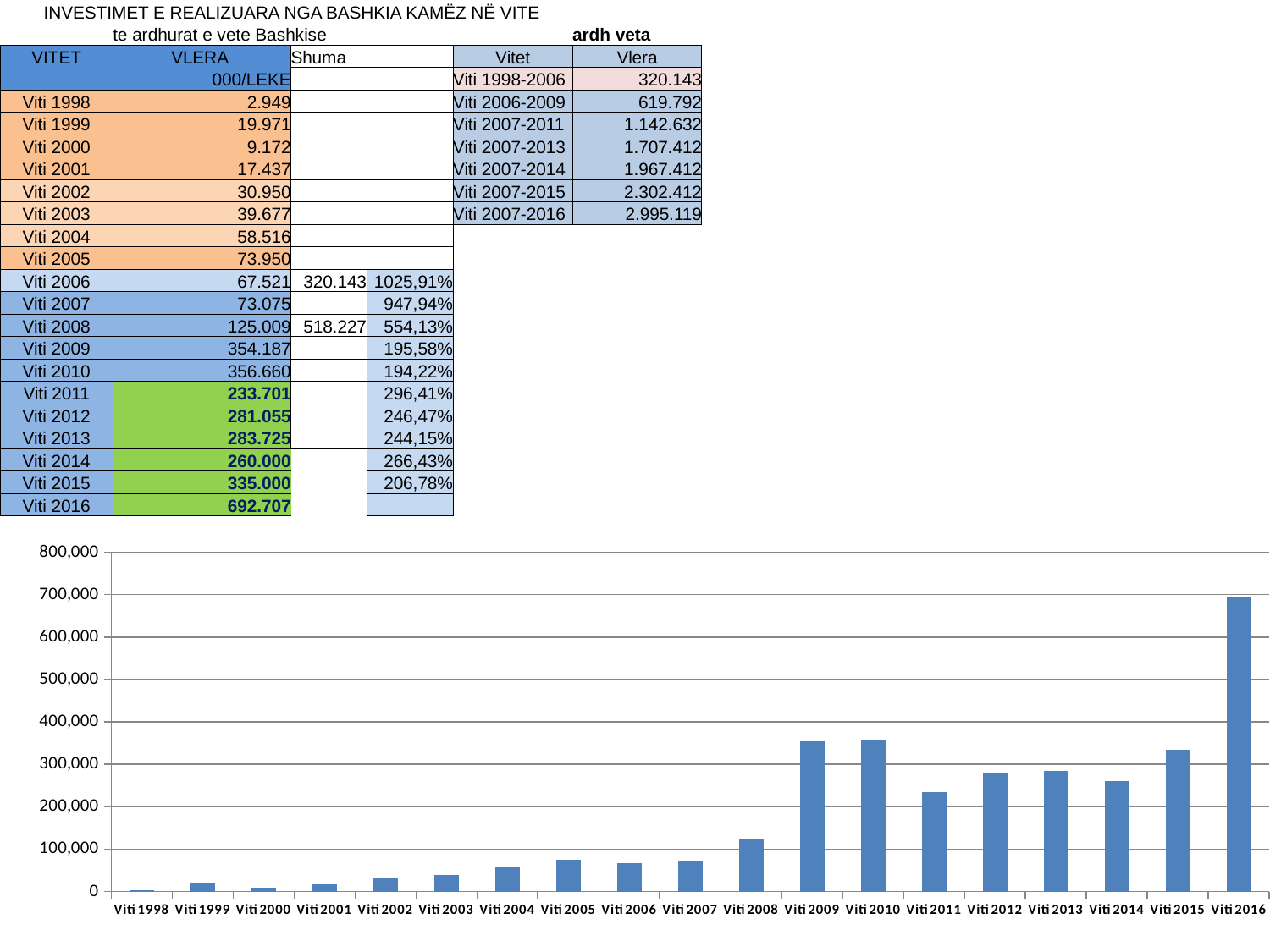
According to the table, what is the value for Viti 2011? 233.701 According to the table, what is the value for Viti 2016? 692.707 Is the bar for Viti 2016 greater or less than 600,000? greater Using the table values, what is the difference between Viti 2016 and Viti 2015? 357.707 Which bar is taller, Viti 2014 or Viti 2015? Viti 2015 Which year has the lowest bar in the chart? Viti 1998 Is the bar for Viti 2009 greater or less than 300,000? greater According to the table, what is the value for Viti 2009? 354.187 How many years (bars) are plotted in the chart? 19 Which year has the highest bar in the chart? Viti 2016 Is the bar for Viti 2011 greater or less than 300,000? less What kind of chart is shown on the slide? bar chart